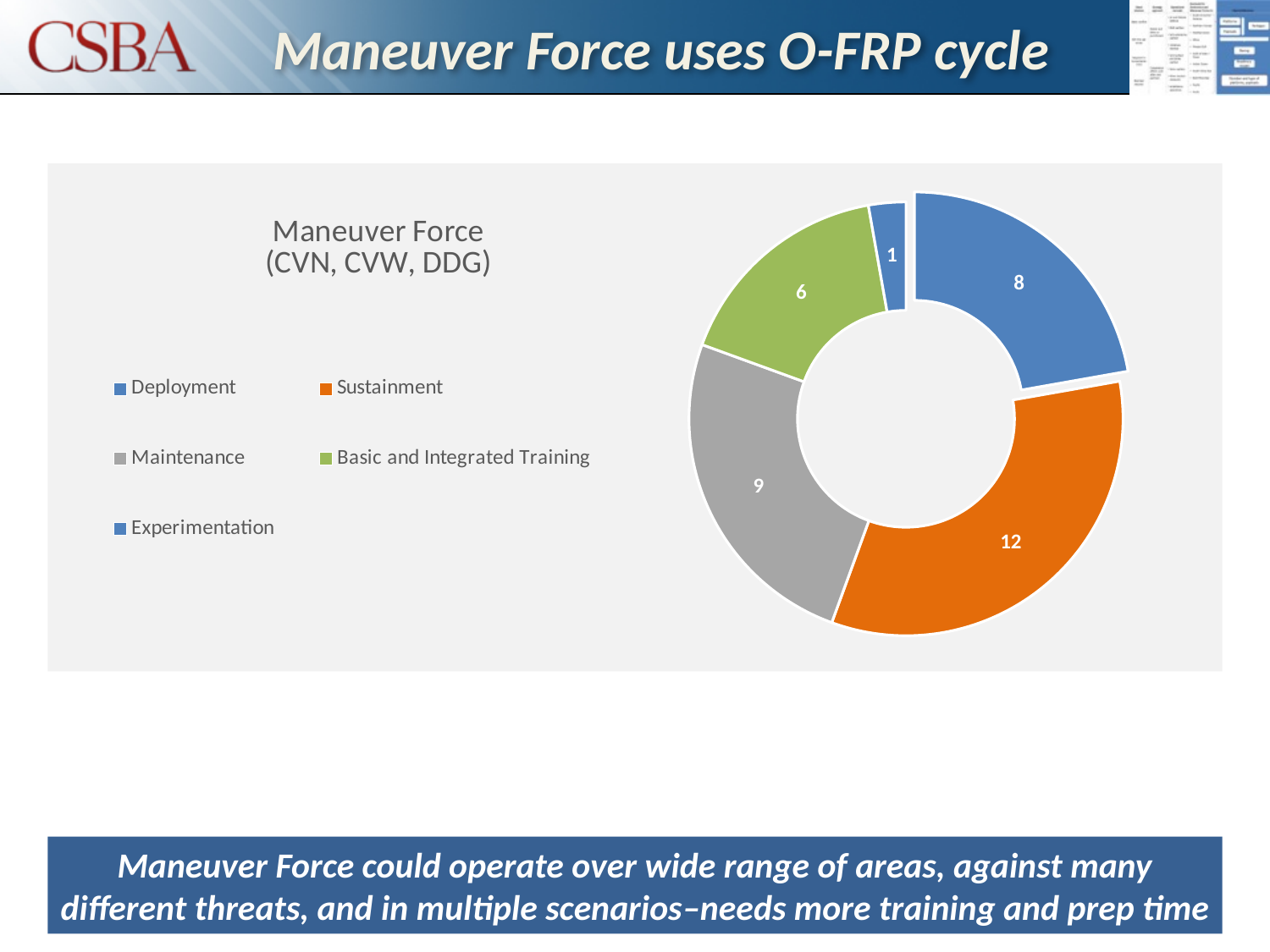
What value is shown for Sustainment in the Maneuver Force (CVN, CVW, DDG) chart? 12 What is the total of all the values shown in the chart? 36 Which category has the smallest value in the chart? Experimentation What is the difference between the Sustainment value and the Deployment value? 4 What kind of chart is shown on the slide? Doughnut (pie) chart Which category has the largest value in the chart? Sustainment What value is shown for Maintenance in the chart? 9 What is the title of the chart? Maneuver Force (CVN, CVW, DDG) Which is larger, the value for Maintenance or the value for Deployment? Maintenance How many categories are shown in the chart? 5 What value is shown for Basic and Integrated Training in the chart? 6 What value is shown for Experimentation in the chart? 1